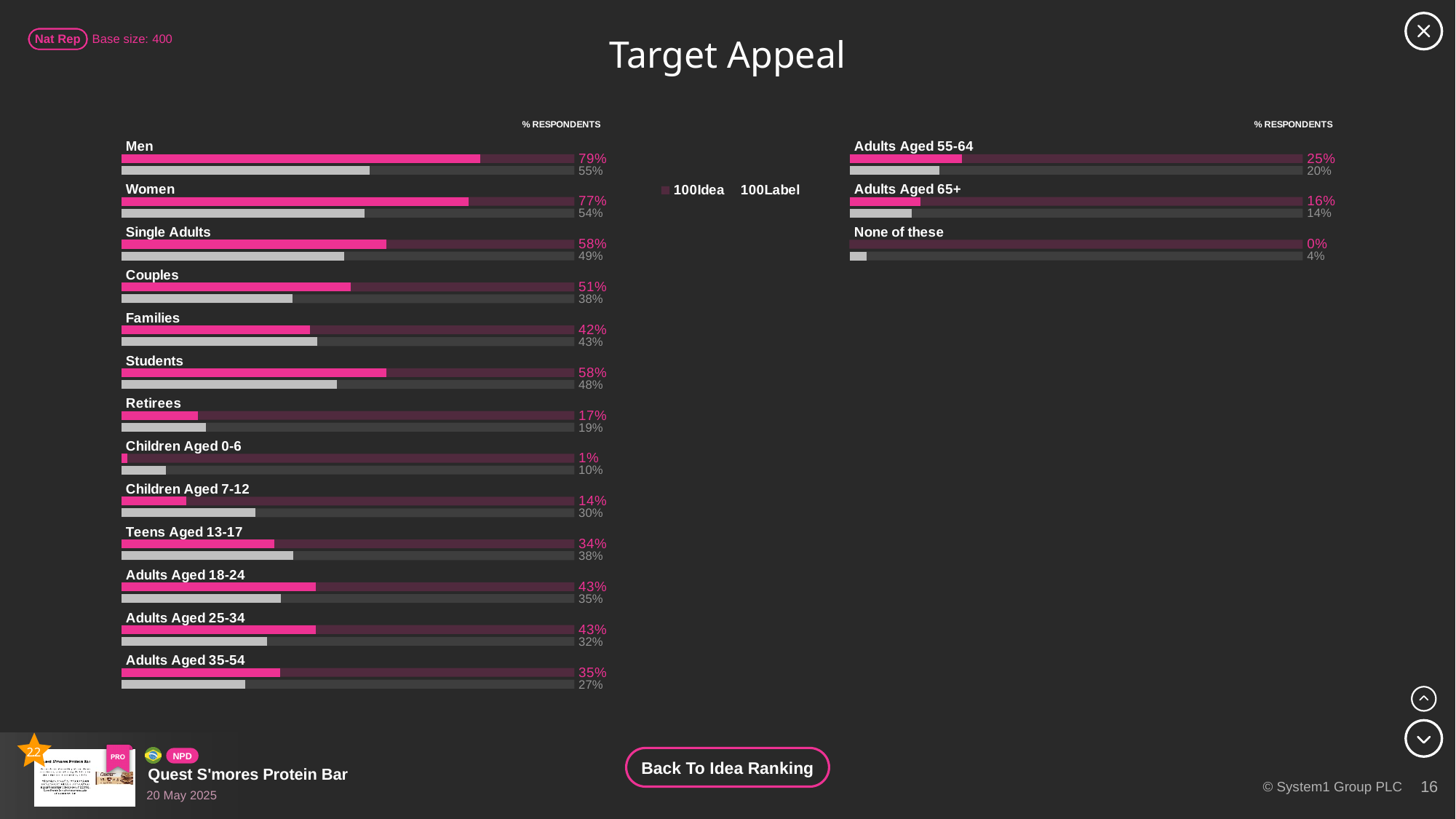
Which has a higher pink (Idea) value: Couples or Teens Aged 13-17? Couples What is the difference between the pink (Idea) values for Women and Single Adults? 19% What is the pink (Idea) value for Adults Aged 55-64? 25% What is the grey (Label) value for Children Aged 7-12? 30% Which is larger for Families: the pink (Idea) value or the grey (Label) value? the grey (Label) value What is the difference between the pink (Idea) value and the grey (Label) value for Men? 24% How many categories are shown across the chart? 16 How many series does the legend list? 2 What kind of chart is shown on the slide? bar chart Which category has the highest pink (Idea) value? Men What is the pink (Idea) value for Men? 79% Which category has the lowest pink (Idea) value? None of these